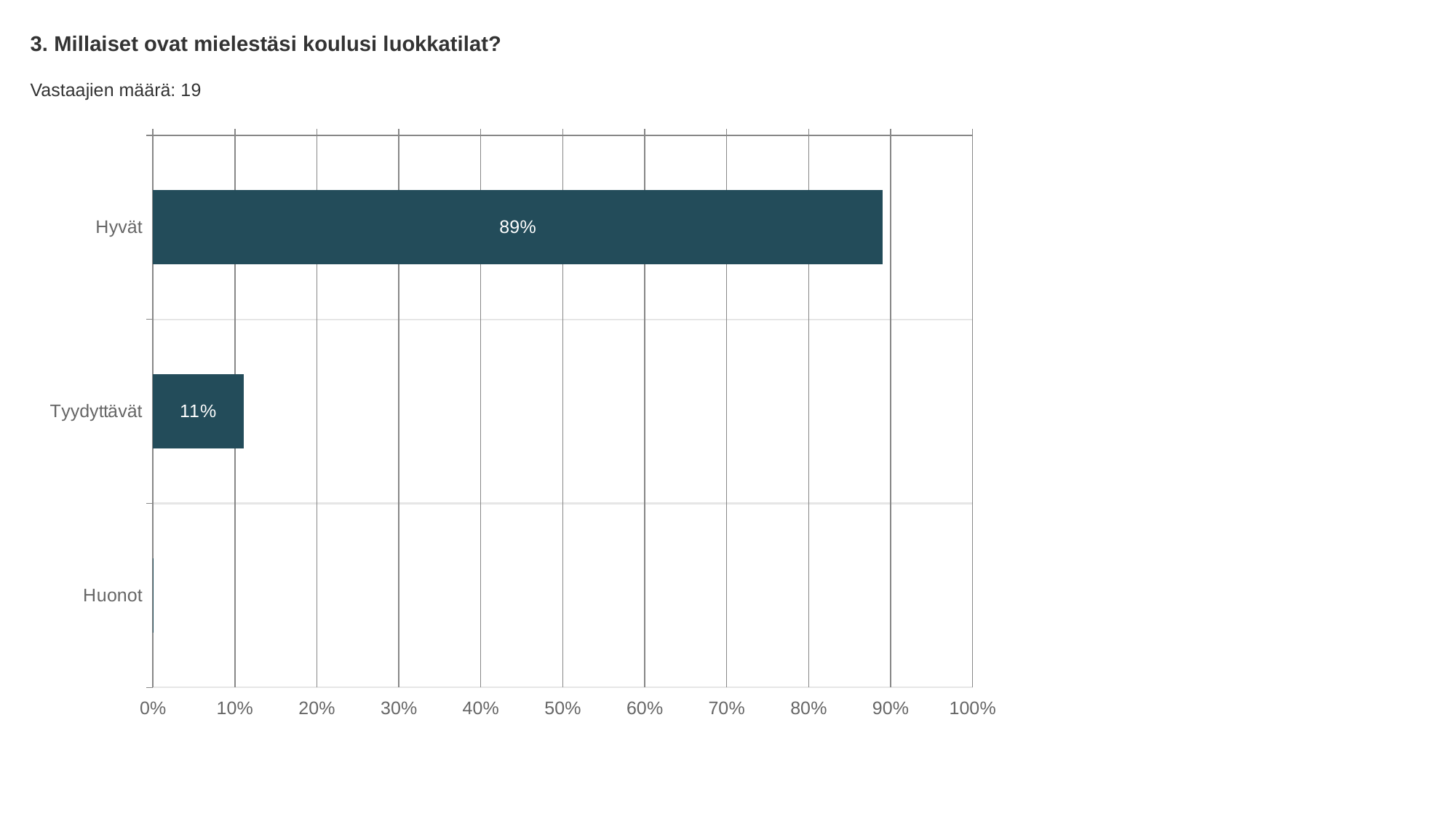
What percentage of respondents answered "Hyvät"? 89% Which category has the lowest value? Huonot Which category has the highest value? Hyvät What kind of chart is shown on the slide? Bar chart How many categories are shown in the chart? 3 What is the difference between the values for "Hyvät" and "Tyydyttävät"? 78% Which is larger, the value for "Hyvät" or the value for "Tyydyttävät"? Hyvät What is the question title shown above the chart? 3. Millaiset ovat mielestäsi koulusi luokkatilat? How many respondents (Vastaajien määrä) are reported on the slide? 19 Is the value for "Hyvät" greater or less than 80%? greater Is the value for "Tyydyttävät" greater or less than 20%? less What percentage of respondents answered "Tyydyttävät"? 11%